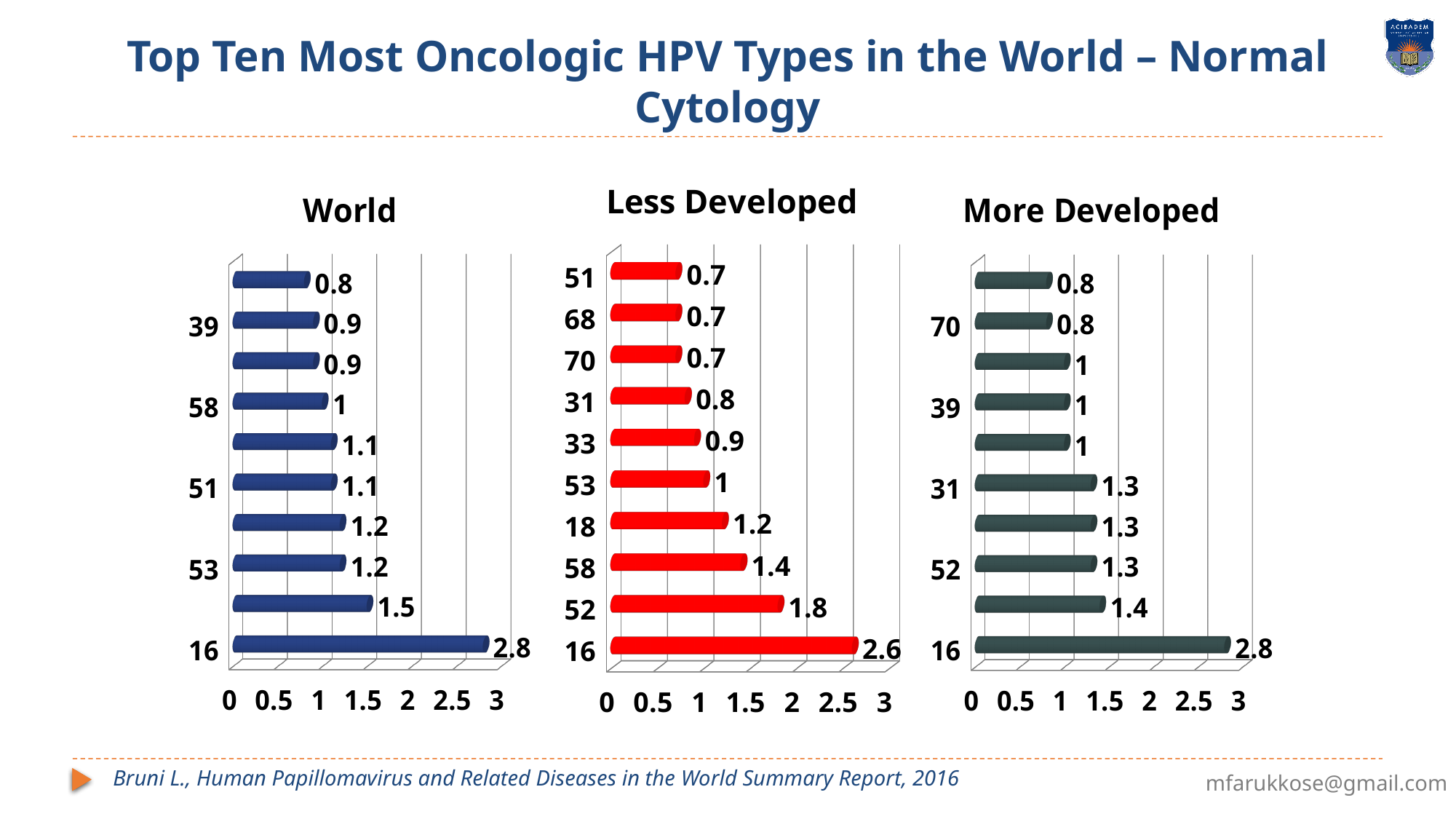
In the More Developed chart, what is the value for HPV type 31? 1.3 In the Less Developed chart, which HPV type has the highest value? 16 What kind of chart is the World chart? bar chart How many charts are shown on the slide? 3 In the Less Developed chart, what is the value for HPV type 18? 1.2 In the World chart, what is the difference between the values for HPV type 16 and HPV type 53? 1.6 How many bars does the Less Developed chart have? 10 In the More Developed chart, is the value for HPV type 16 greater or less than 2.5? greater In the Less Developed chart, what is the value for HPV type 52? 1.8 In the Less Developed chart, which is larger, the value for HPV type 58 or HPV type 33? 58 In the World chart, what is the value for HPV type 16? 2.8 In the Less Developed chart, what is the difference between the values for HPV type 16 and HPV type 52? 0.8